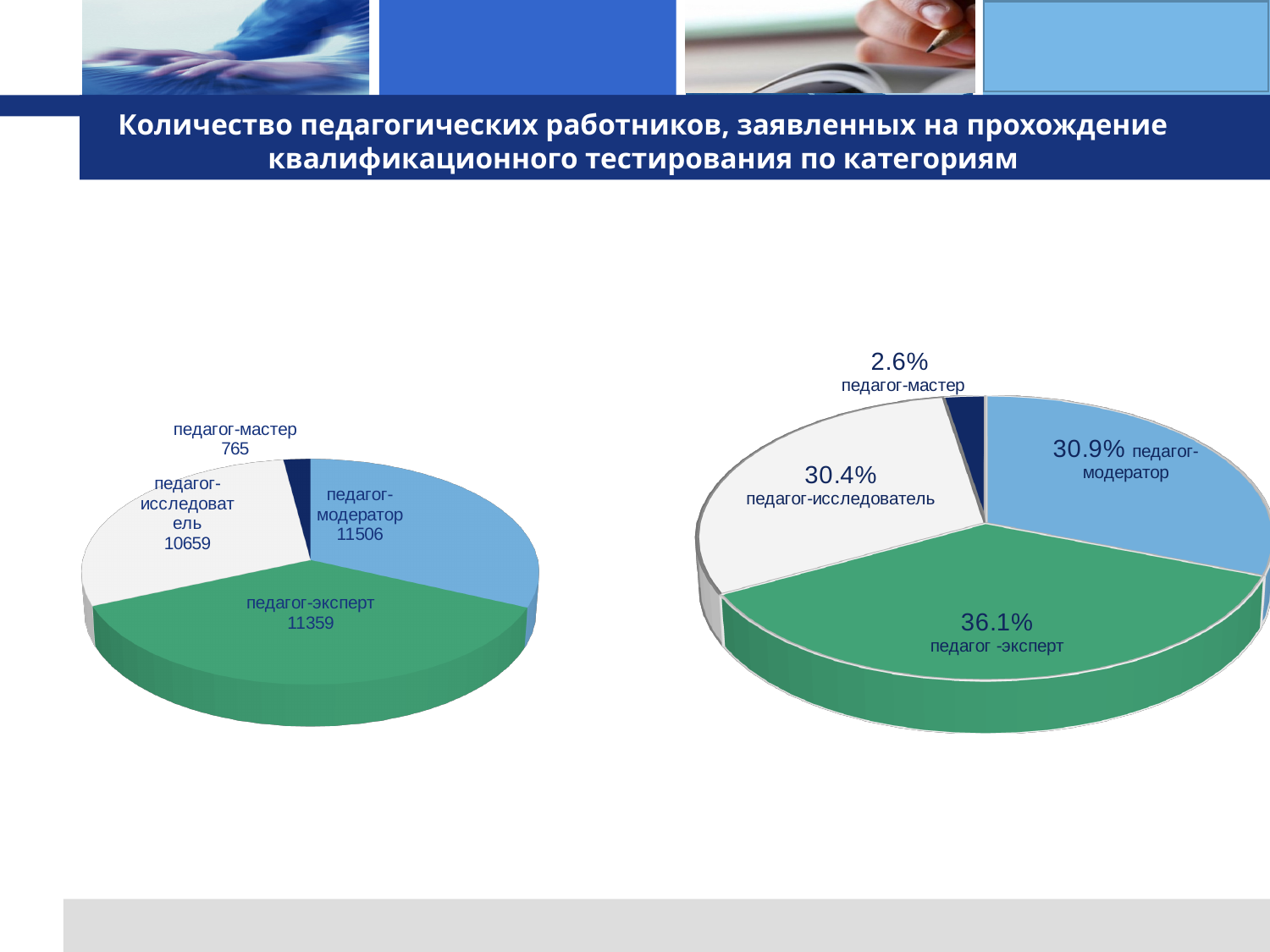
In the right pie chart, what share does педагог-эксперт have? 36.1% In the left pie chart, what is the difference between the values for педагог-эксперт and педагог-исследователь? 700 How many categories are shown in the left pie chart? 4 In the left pie chart, which category has the lowest value? педагог-мастер In the left pie chart, what is the value for педагог-эксперт? 11359 In the right pie chart, what share does педагог-мастер have? 2.6% What kind of chart is the chart on the left of the slide? pie chart In the left pie chart, what is the value for педагог-мастер? 765 In the right pie chart, which is larger: the share for педагог-модератор or педагог-исследователь? педагог-модератор In the right pie chart, which category has the largest share? педагог-эксперт In the left pie chart, what is the value for педагог-исследователь? 10659 In the left pie chart, what is the value for педагог-модератор? 11506